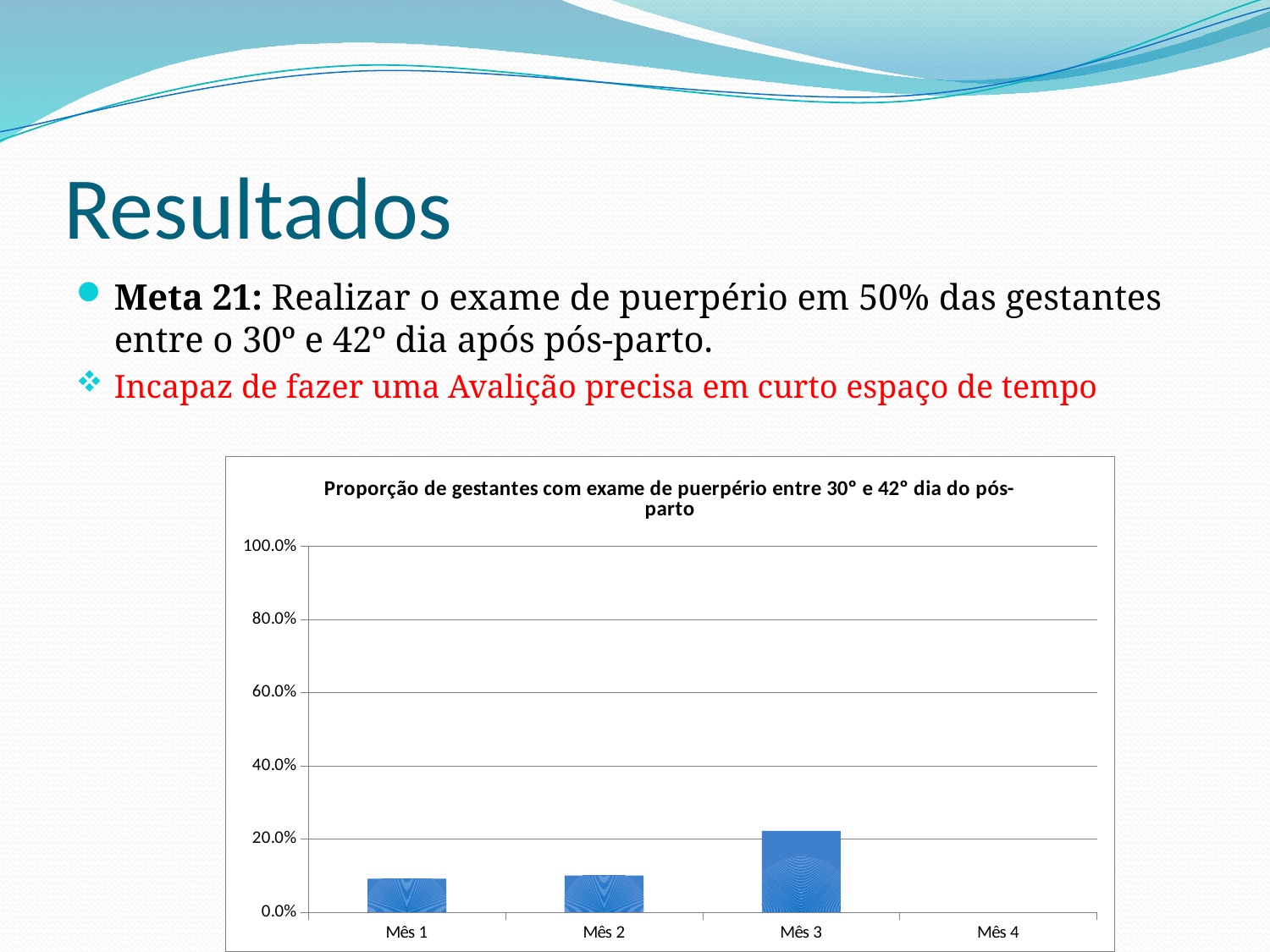
Which is larger, the value for Mês 3 or the value for Mês 1? Mês 3 How many categories (months) are shown on the x axis of the chart? 4 What kind of chart is shown on the slide? bar chart What is the highest value shown on the y axis of the chart? 100.0% Do the values rise or fall from Mês 1 to Mês 3? rise What is the title of the chart? Proporção de gestantes com exame de puerpério entre 30° e 42° dia do pós-parto Is the value for Mês 3 greater or less than 40.0%? less Which month has the highest value in the chart? Mês 3 Which month shows no bar at all in the chart? Mês 4 Is the value for Mês 3 greater or less than 20.0%? greater Is the value for Mês 2 greater or less than 20.0%? less